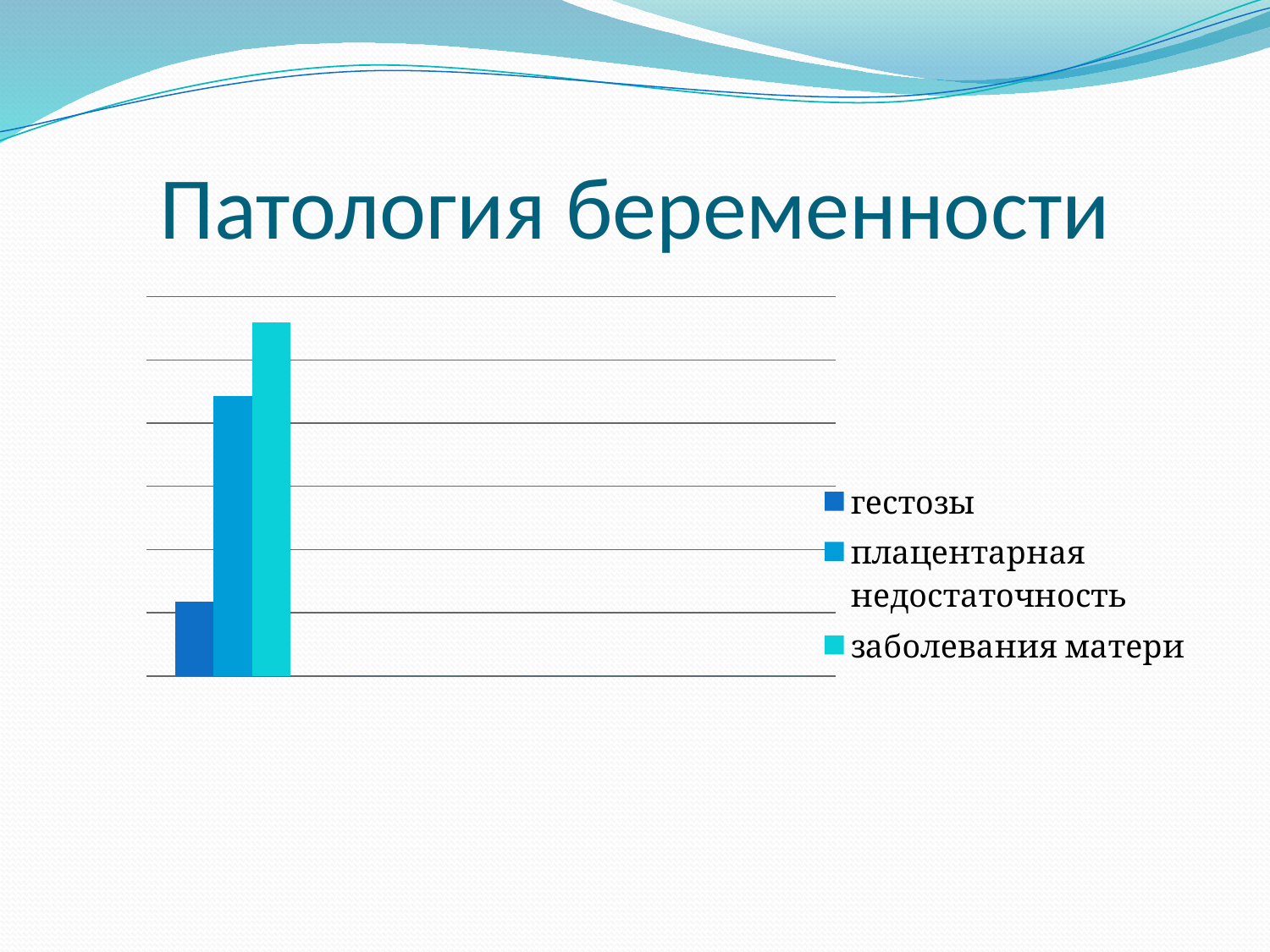
Which bar is shorter: гестозы or заболевания матери? гестозы How many bars are plotted in the chart? 3 Which series has the tallest bar in the chart? заболевания матери Which series has the shortest bar in the chart? гестозы How many series does the chart legend list? 3 What kind of chart is shown on the slide? bar chart Which bar is taller: плацентарная недостаточность or заболевания матери? заболевания матери Which legend entry is listed first in the chart legend? гестозы What is the title of the slide containing the chart? Патология беременности Which bar is taller: гестозы or плацентарная недостаточность? плацентарная недостаточность